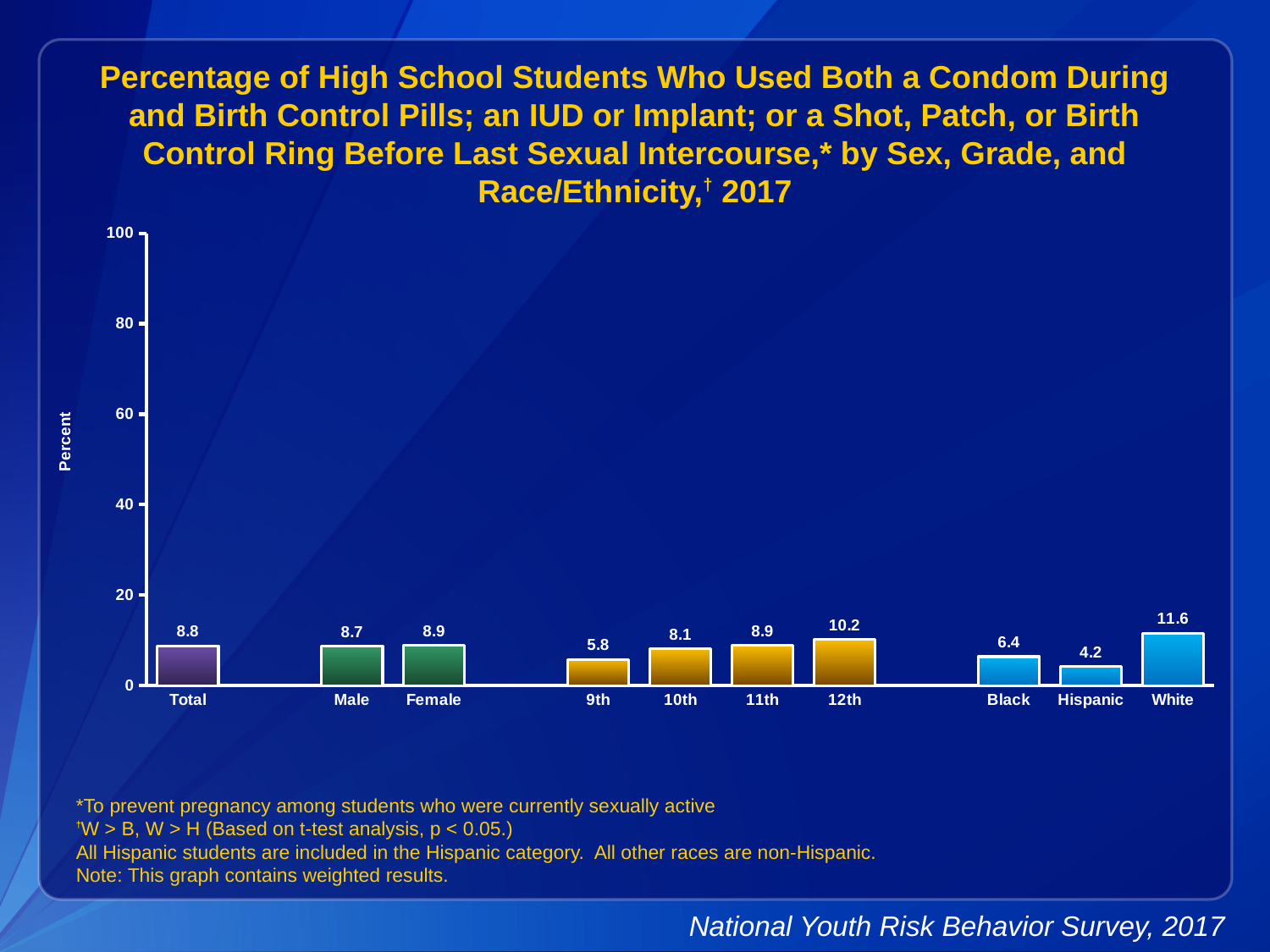
Do the values rise or fall from 9th grade to 12th grade? rise Which is larger, the value for Male or the value for Female? Female Is the value for White students greater or less than 20? less What kind of chart is this? bar chart What is the difference between the values for White and Black students? 5.2 Which category has the lowest value? Hispanic Which category has the highest value? White What is the value for 12th grade? 10.2 What is the value for Total? 8.8 How many categories are shown on the x axis? 10 What is the value for Hispanic students? 4.2 What is the difference between the values for 12th grade and 9th grade? 4.4